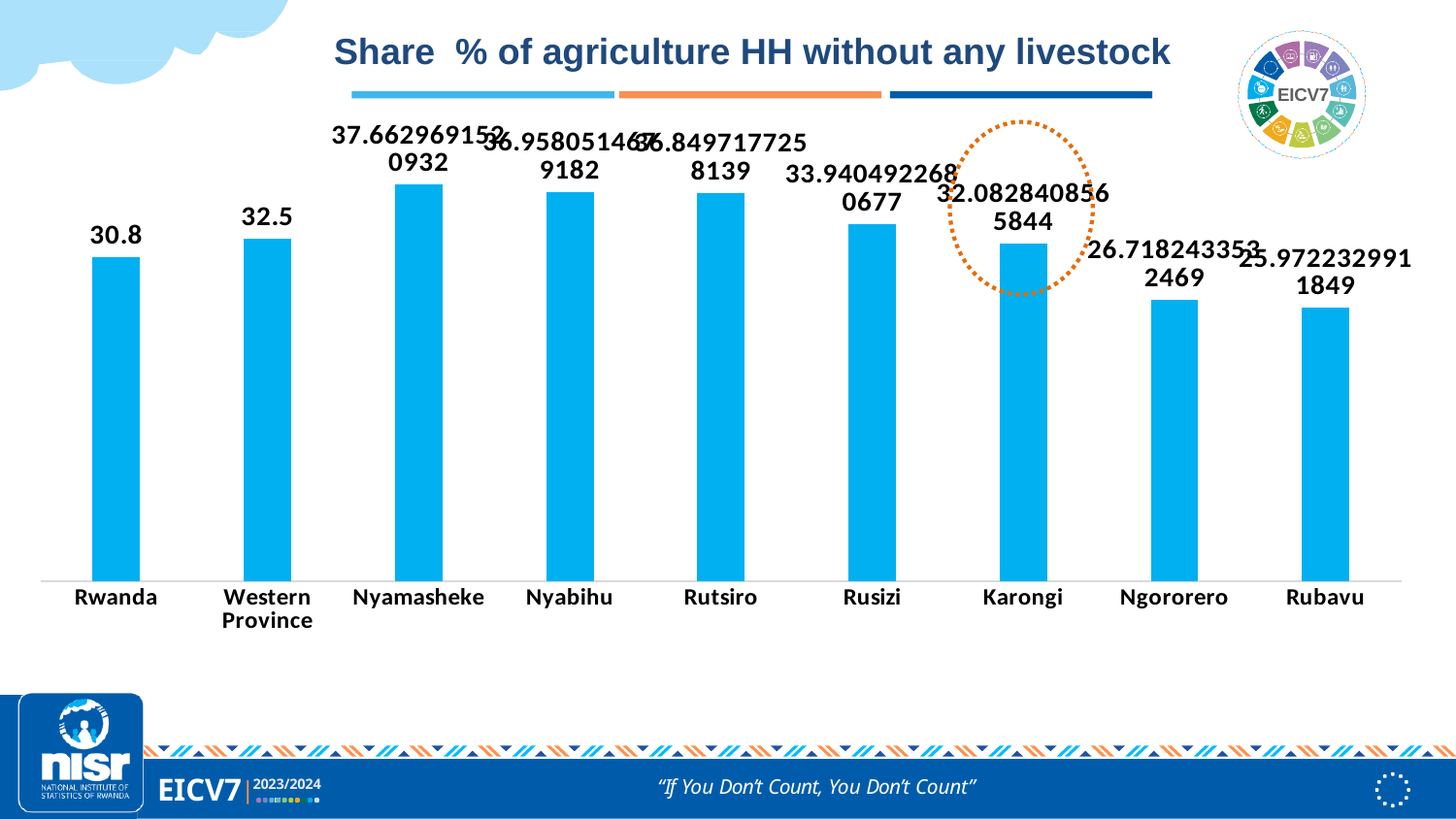
What is the value for Rwanda? 30.8 What kind of chart is shown on the slide? Bar chart Which category has the highest value? Nyamasheke Which is larger, the value for Rusizi or the value for Karongi? Rusizi What is the difference between the values for Western Province and Rwanda? 1.7 Which category's bar is highlighted with a dashed orange oval? Karongi Do the values rise or fall from Nyamasheke to Rubavu along the x axis? Fall What is the value shown for Nyamasheke? 37.6629691520932 Which category has the lowest value? Rubavu What is the value shown for Karongi? 32.0828408565844 How many categories are shown on the x axis? 9 What is the value for Western Province? 32.5